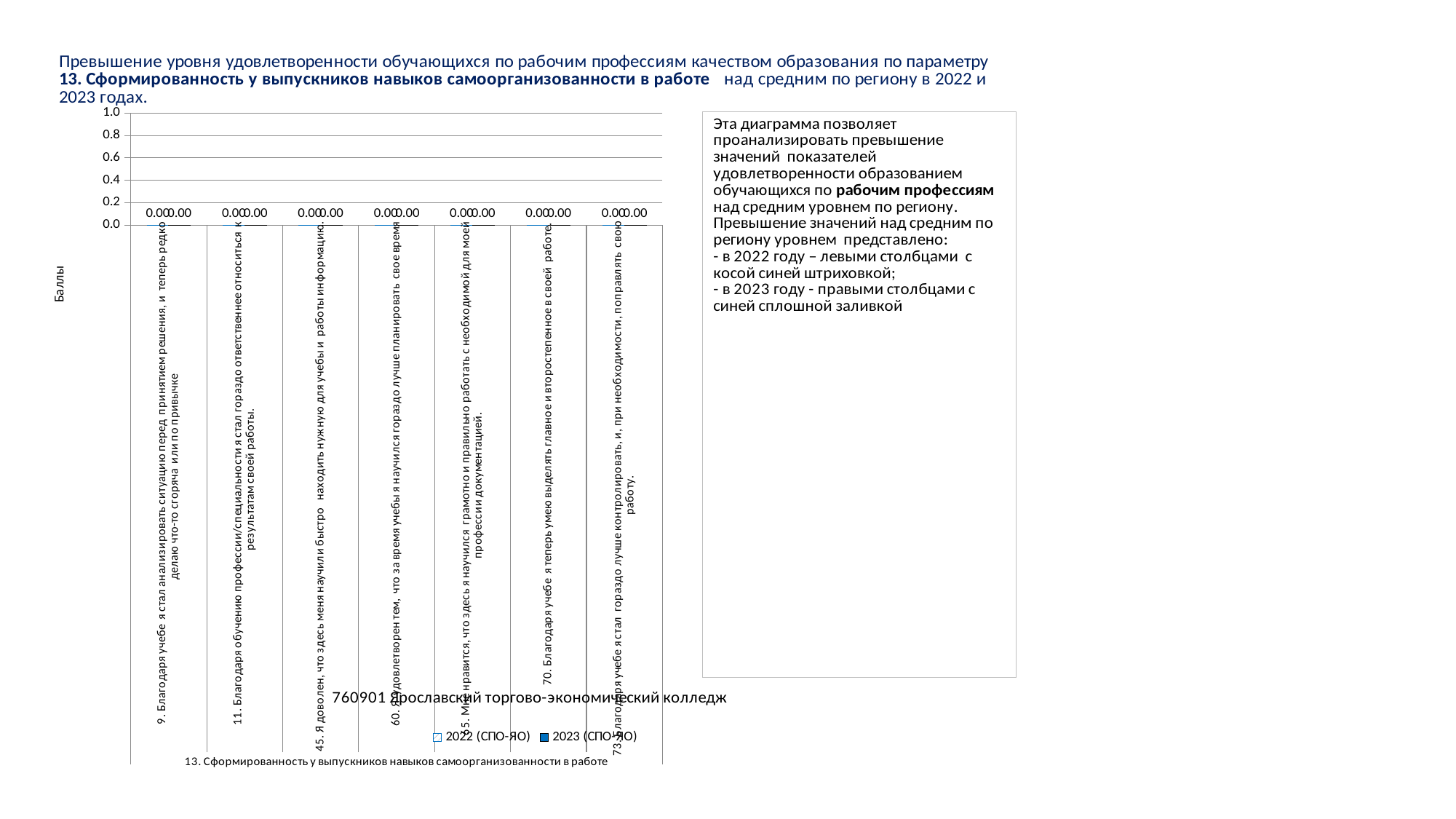
What is the value of the 2022 (СПО-ЯО) series for category 45 ("Я доволен, что здесь меня научили быстро находить нужную для учебы и работы информацию")? 0.00 What is the difference between the 2022 (СПО-ЯО) and 2023 (СПО-ЯО) values for category 11? 0.00 What kind of chart is shown on the slide? bar chart What is the highest tick value shown on the vertical axis of the chart? 1.0 What is the value of the 2023 (СПО-ЯО) series for category 73 ("Благодаря учебе я стал гораздо лучше контролировать... свою работу")? 0.00 What is the value of the 2022 (СПО-ЯО) series for category 9 ("Благодаря учебе я стал анализировать ситуацию перед принятием решения...")? 0.00 Is the value of the 2023 (СПО-ЯО) series for category 60 greater or less than 0.2? less How many categories (survey statements) are plotted along the x axis of the chart? 7 What is the value of the 2023 (СПО-ЯО) series for category 70 ("Благодаря учебе я теперь умею выделять главное и второстепенное в своей работе")? 0.00 What is the label of the vertical axis of the chart? Баллы How many series does the chart legend list? 2 What are the two series named in the chart legend? 2022 (СПО-ЯО) and 2023 (СПО-ЯО)